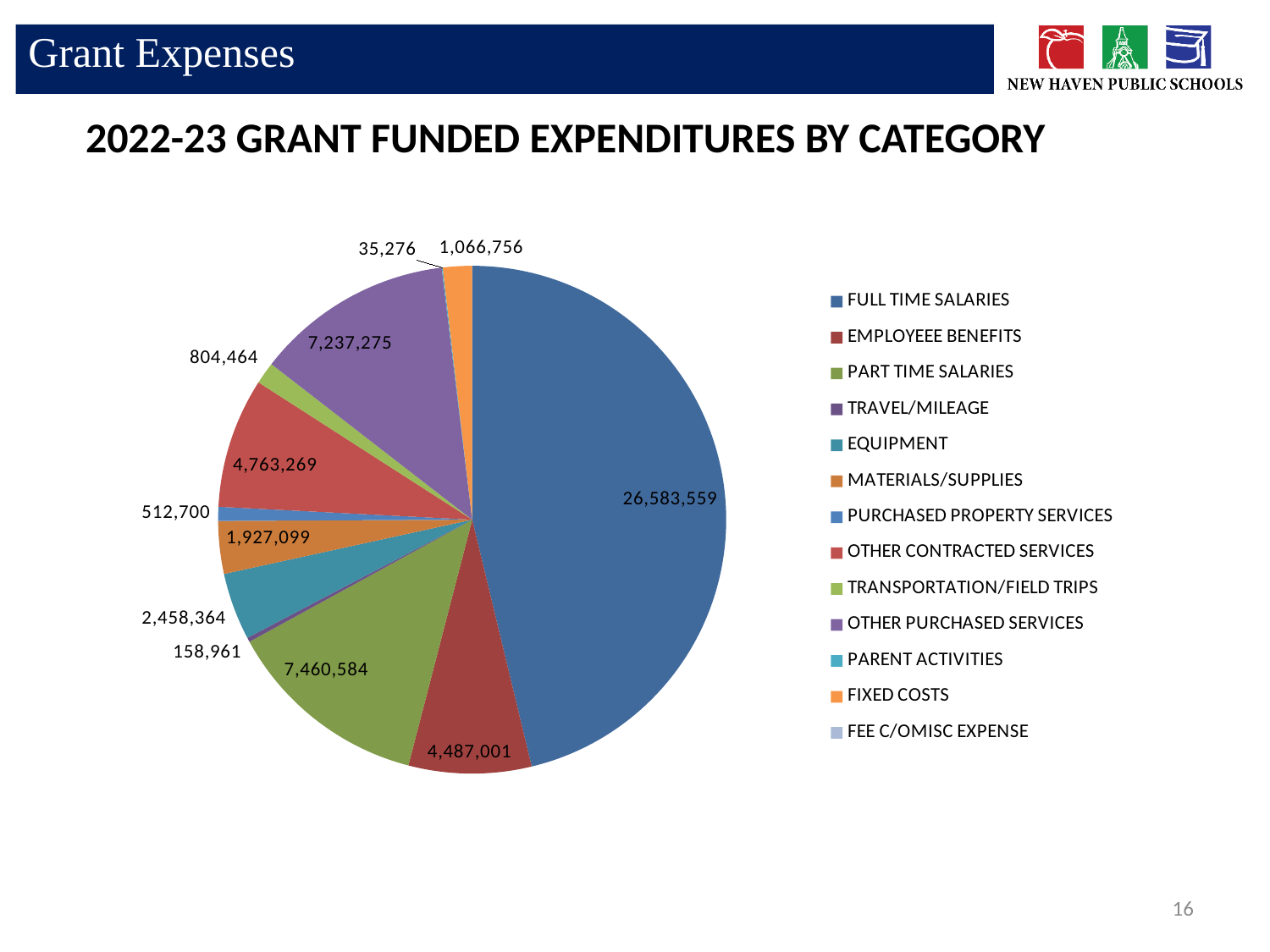
What is the value for PARENT ACTIVITIES? 35,276 What is the difference between PART TIME SALARIES and OTHER PURCHASED SERVICES? 223,309 Which category has the largest slice of the pie? FULL TIME SALARIES Which is larger, PART TIME SALARIES or OTHER PURCHASED SERVICES? PART TIME SALARIES What is the value for EQUIPMENT? 2,458,364 How many categories does the legend list? 13 What is the value for FULL TIME SALARIES? 26,583,559 What is the value for OTHER PURCHASED SERVICES? 7,237,275 What is the value for PART TIME SALARIES? 7,460,584 What is the title of the chart? 2022-23 GRANT FUNDED EXPENDITURES BY CATEGORY What is the difference between OTHER CONTRACTED SERVICES and EMPLOYEEE BENEFITS? 276,268 What type of chart is shown on the slide? Pie chart